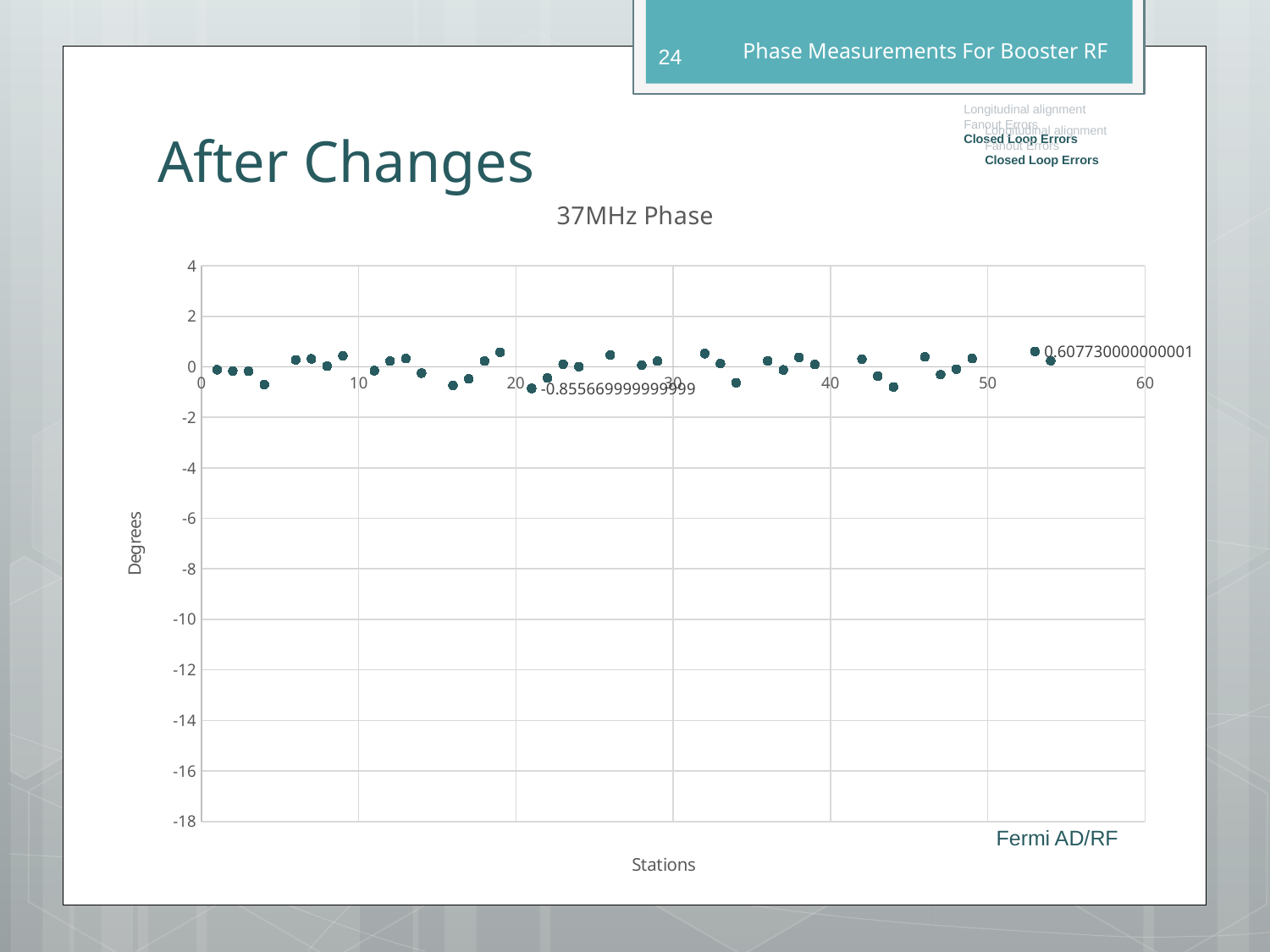
Which of the two labeled values in the chart is larger, the one near station 21 or the one near station 53? the one near station 53 (0.607730000000001) What kind of chart is shown on the slide? scatter chart What is the lowest value shown on the vertical axis of the chart? -18 What is the label of the vertical axis of the chart? Degrees What value is printed on the data label near station 53, at the right end of the 37MHz Phase chart? 0.607730000000001 Are all the plotted values in the 37MHz Phase chart greater or less than -2 degrees? greater Do the plotted phase values show a clear rise, a clear fall, or stay roughly flat across the stations? roughly flat What value is printed on the data label near station 21 in the 37MHz Phase chart? -0.855669999999999 What is the title of the chart? 37MHz Phase Are all the plotted values in the 37MHz Phase chart greater or less than 2 degrees? less What is the difference between the two labeled values, 0.607730000000001 and -0.855669999999999? 1.4634